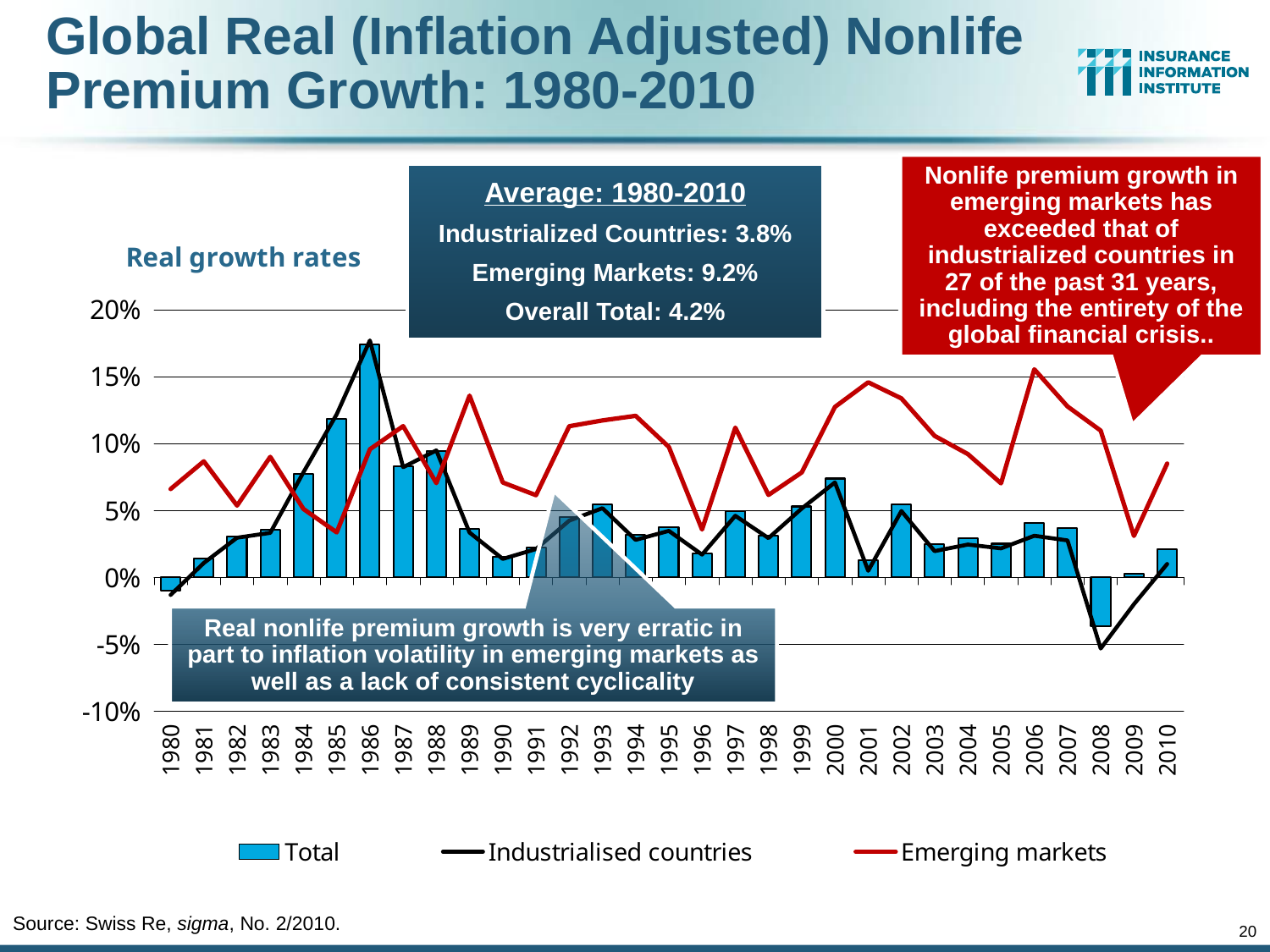
What kind of chart is shown on the slide? A combination chart with bars and lines Is the Industrialised countries value for 2008 greater or less than 0%? less In which year is the Total bar the highest? 1986 In 2001, which is larger: the Emerging markets value or the Industrialised countries value? Emerging markets Do the Total bars rise or fall from 1984 to 1986? rise How many series does the legend list? 3 In which year is the Total bar the lowest? 2008 How many years are shown along the x axis? 31 Is the Total value for 1986 greater or less than 15%? greater Is the Total value for 1985 greater or less than 10%? greater What colour is the Emerging markets line in the legend? Red